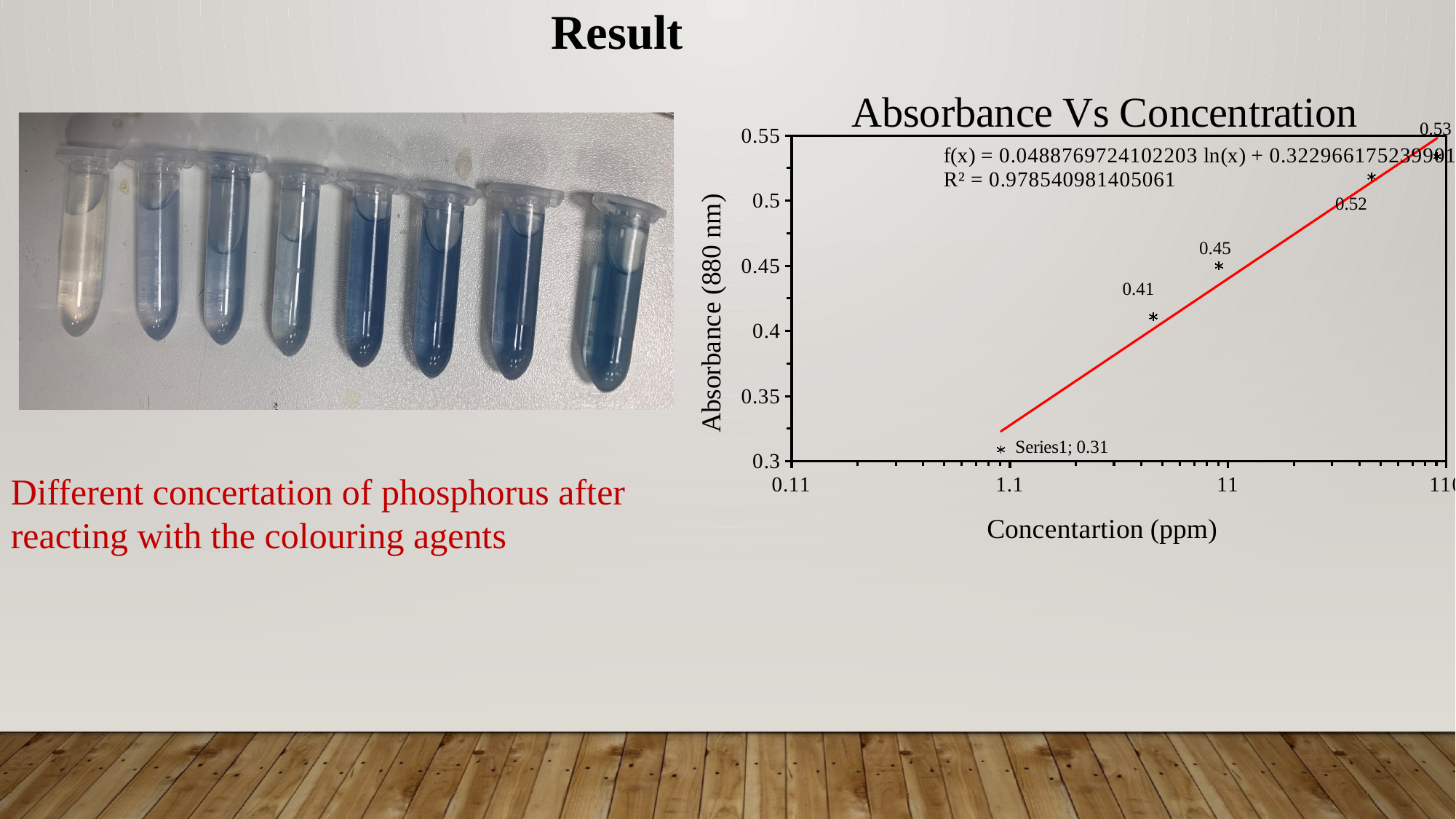
What is the title of the chart? Absorbance Vs Concentration What is the difference between the highest labelled absorbance (0.53) and the lowest labelled absorbance (0.31)? 0.22 What is the R² value shown on the chart? 0.978540981405061 What kind of chart is shown on the slide? scatter chart Is the absorbance of the data point labelled 0.52 greater or less than 0.5? greater Is the absorbance of the data point labelled 0.31 greater or less than 0.35? less How many data points are plotted in the Absorbance Vs Concentration chart? 5 What is the highest absorbance value labelled on the chart? 0.53 Do the absorbance values rise or fall as concentration increases along the x axis? rise Which is larger, the absorbance labelled 0.45 or the absorbance labelled 0.41? 0.45 What is the absorbance value of the data point labelled with the series name 'Series1'? 0.31 What is the lowest absorbance value labelled on the chart? 0.31